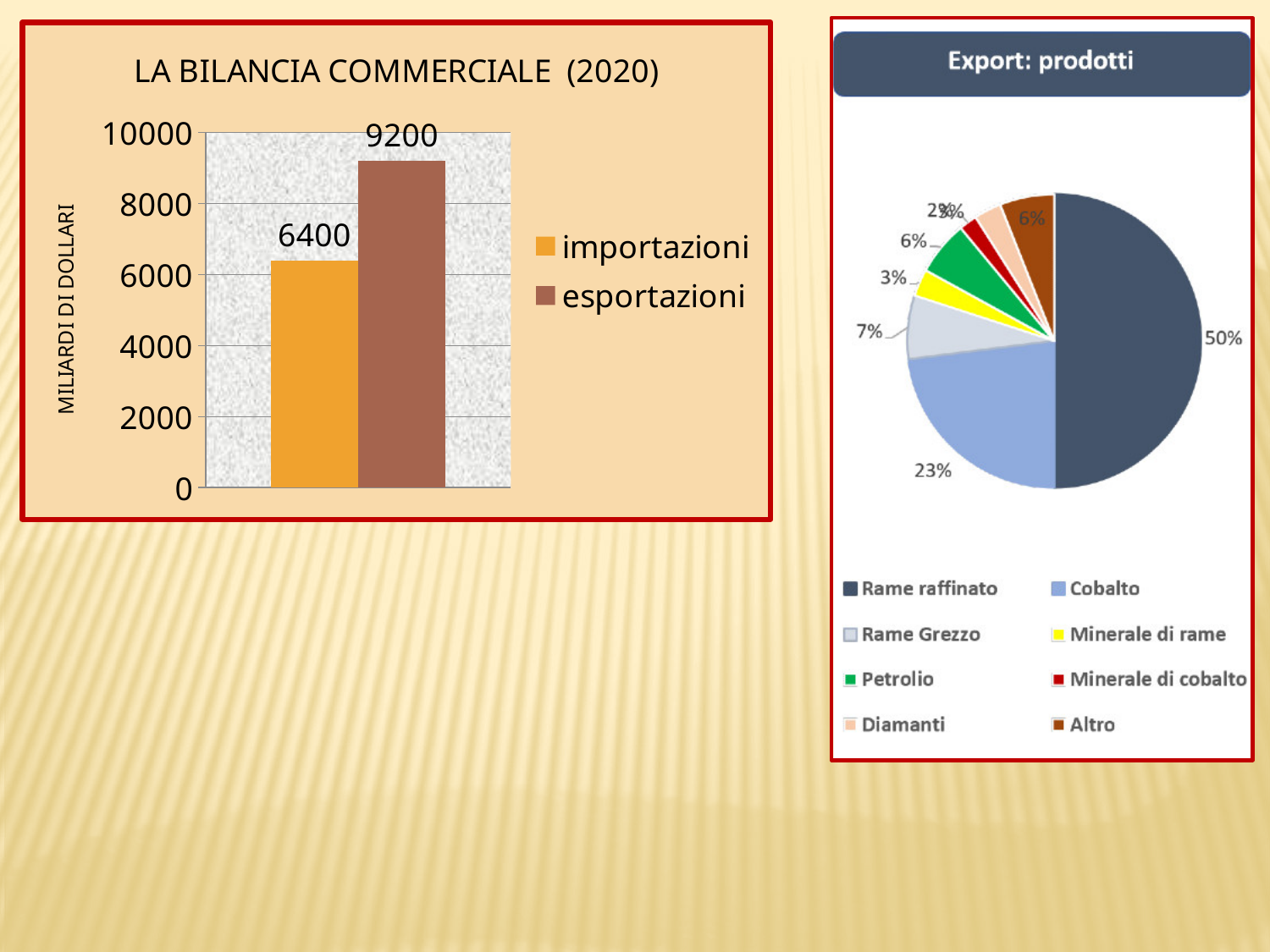
What kind of chart is the one titled 'Export: prodotti'? pie chart In the pie chart titled 'Export: prodotti', what share does Rame raffinato have? 50% In the chart titled 'LA BILANCIA COMMERCIALE (2020)', what is the value for importazioni? 6400 In the pie chart titled 'Export: prodotti', which product has the largest slice? Rame raffinato In the chart titled 'LA BILANCIA COMMERCIALE (2020)', what is the label of the vertical axis? MILIARDI DI DOLLARI In the chart titled 'LA BILANCIA COMMERCIALE (2020)', what is the difference between esportazioni and importazioni? 2800 What kind of chart is the one titled 'LA BILANCIA COMMERCIALE (2020)'? bar chart In the chart titled 'LA BILANCIA COMMERCIALE (2020)', how many series does the legend list? 2 In the pie chart titled 'Export: prodotti', what share does Cobalto have? 23% In the chart titled 'LA BILANCIA COMMERCIALE (2020)', what is the value for esportazioni? 9200 In the chart titled 'LA BILANCIA COMMERCIALE (2020)', which is larger, importazioni or esportazioni? esportazioni In the pie chart titled 'Export: prodotti', how many categories does the legend list? 8